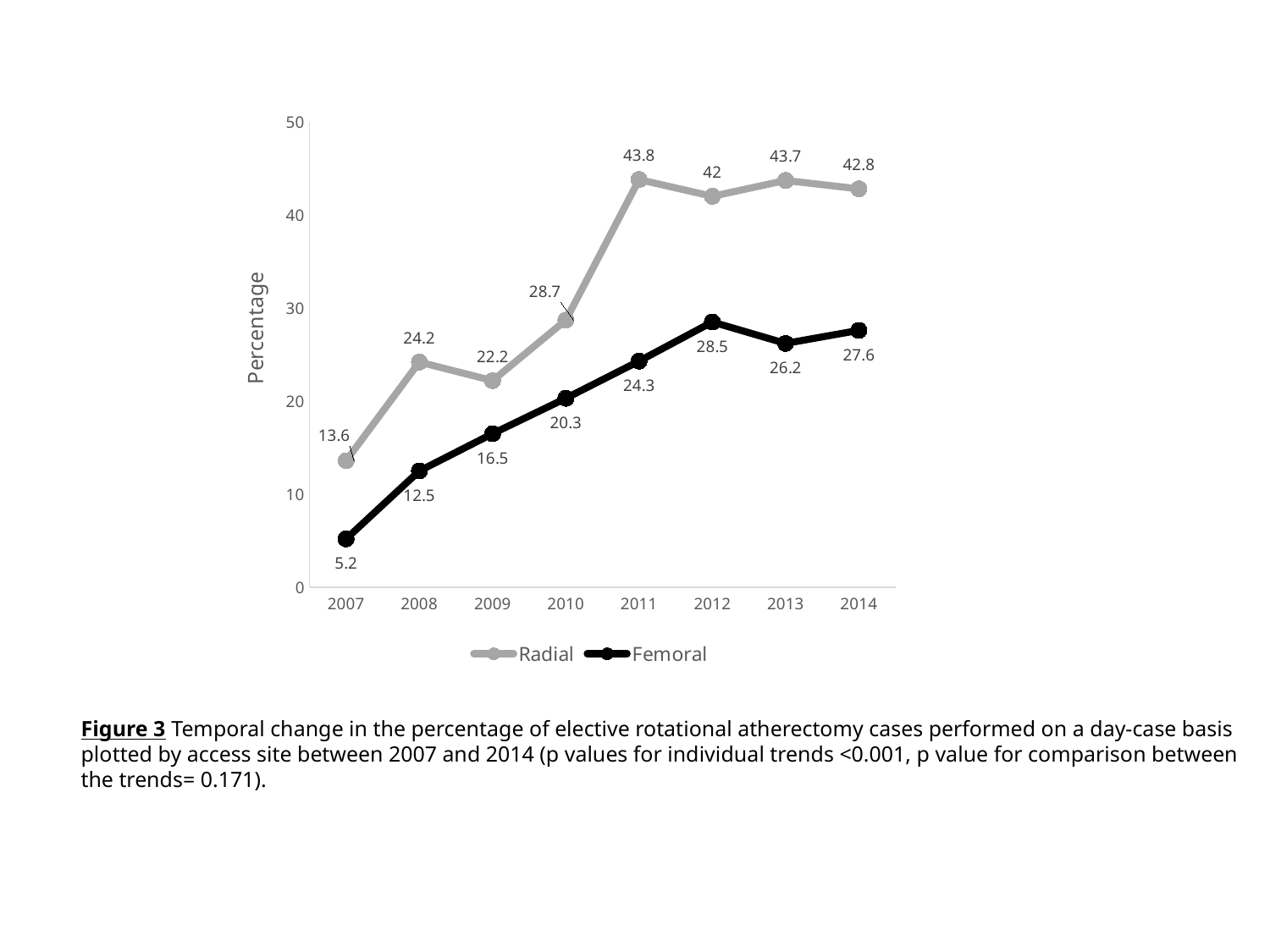
What is the Radial value for 2014? 42.8 Is the Radial value for 2010 greater or less than 30? less What is the difference between the Radial and Femoral values in 2014? 15.2 In which year is the Femoral series lowest? 2007 What kind of chart is shown on the slide? line chart How many years are plotted on the x axis? 8 How many series does the legend list? 2 What is the Femoral value for 2012? 28.5 What is the Femoral value for 2007? 5.2 What is the Radial value for 2011? 43.8 In which year is the Radial series highest? 2011 Which is larger in 2009, the Radial value or the Femoral value? Radial